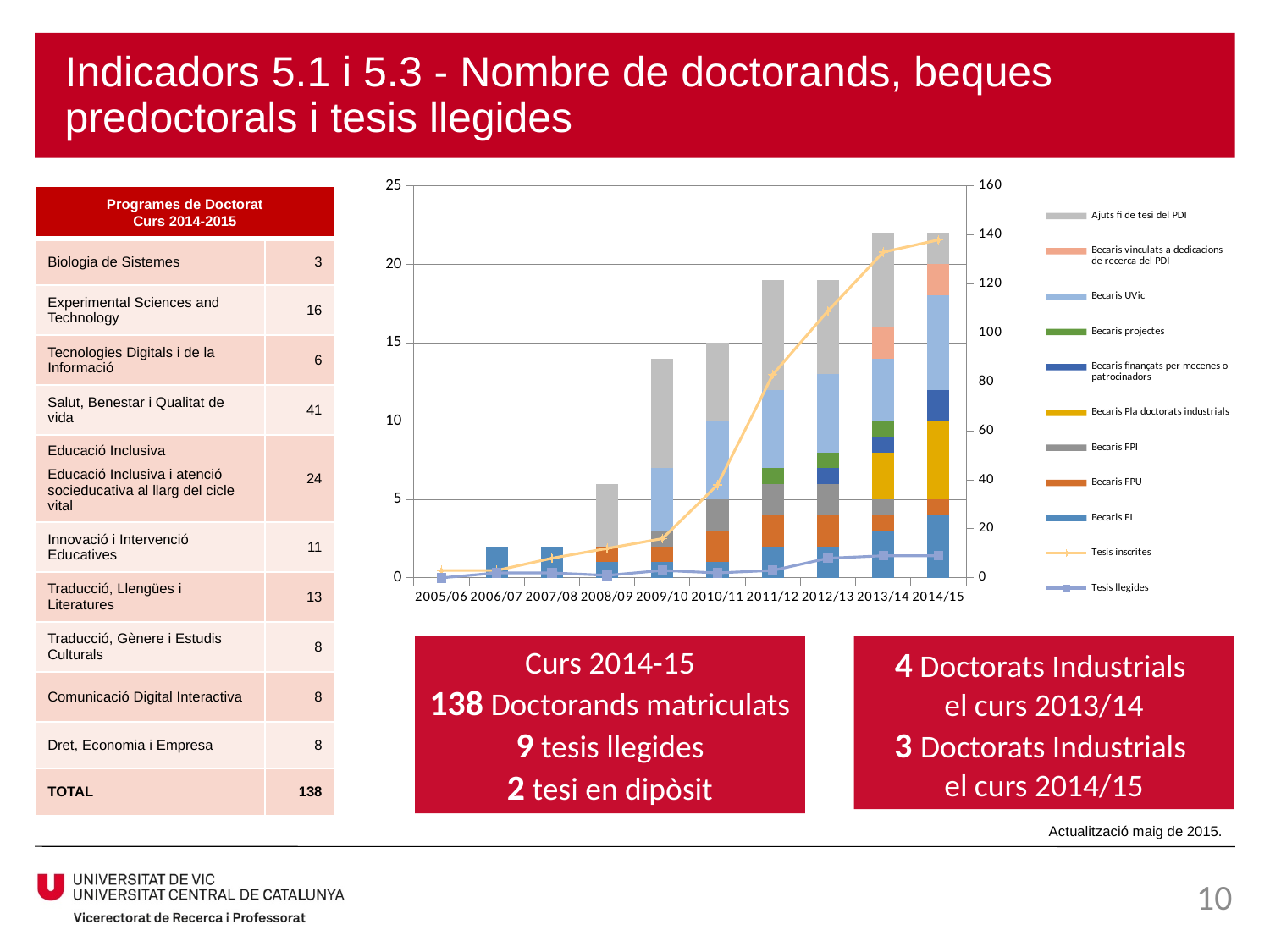
Is the stacked bar total for 2008/09 greater or less than 10? less How many academic years are shown on the x axis of the chart? 10 Does the Tesis inscrites line rise or fall from 2005/06 to 2014/15? rises Which series is plotted as a line with plus-shaped markers? Tesis inscrites Is the stacked bar total for 2009/10 greater or less than 10? greater How many series does the chart legend list? 11 Which has the larger stacked bar total, 2008/09 or 2009/10? 2009/10 What kind of chart is shown on the slide? combination bar and line chart (stacked bars with lines) Which series in the chart is shown in yellow? Becaris Pla doctorats industrials Which academic year has the lowest stacked bar total in the chart? 2005/06 Is the stacked bar total for 2013/14 greater or less than 20? greater